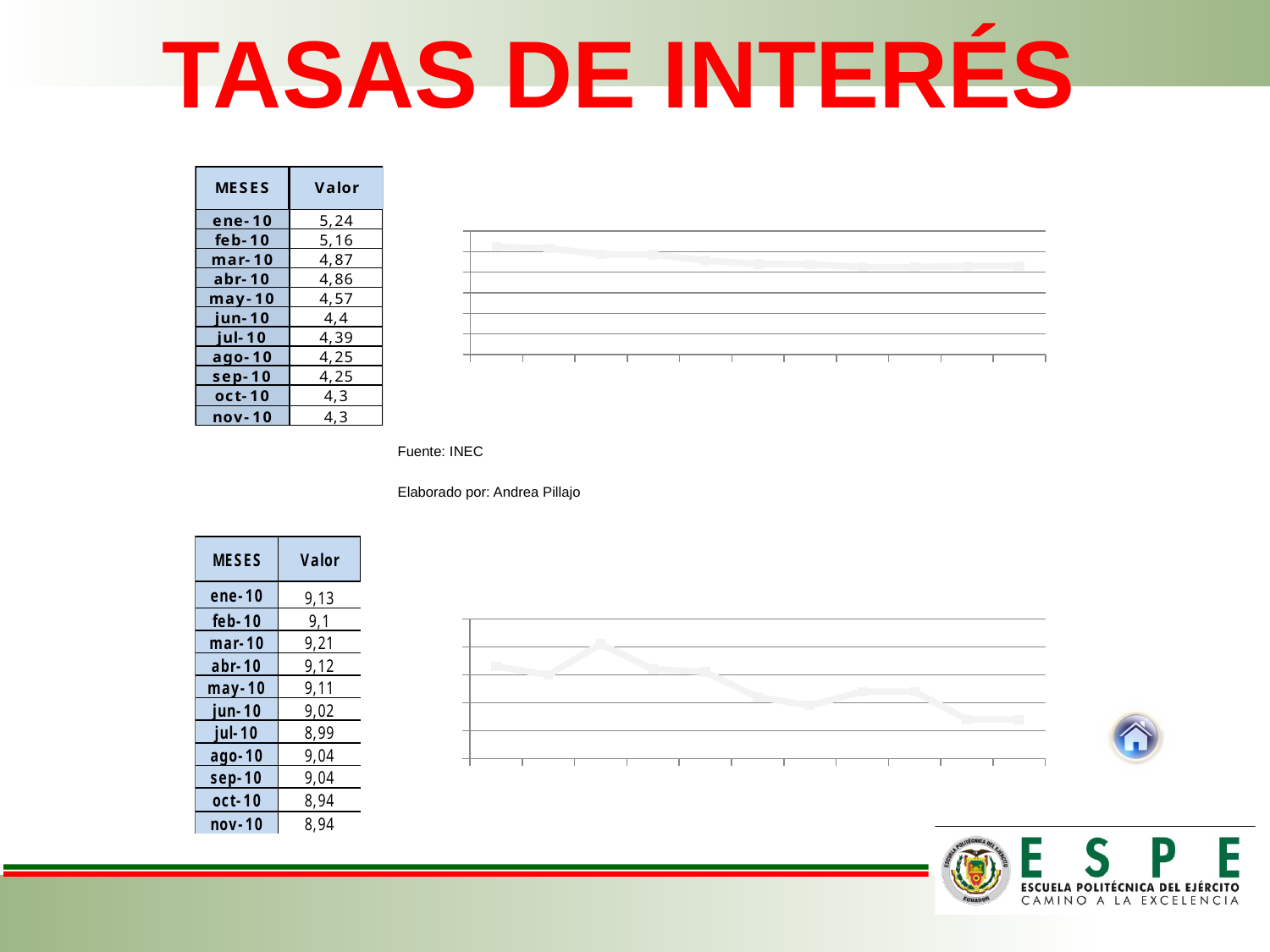
What kind of chart is the top chart on the slide? line chart In the top chart, which month has the highest value? ene-10 In the bottom chart, which month has the highest value? mar-10 In the top chart's table, what is the value for ene-10? 5,24 What kind of chart is the bottom chart on the slide? line chart In the bottom chart, what is the difference between the values for mar-10 and nov-10? 0,27 In the bottom chart's table, what is the value for jul-10? 8,99 In the top chart, do the values rise or fall from ene-10 to nov-10? fall In the top chart, what is the difference between the values for ene-10 and nov-10? 0,94 In the bottom chart, which is larger, the value for mar-10 or the value for jun-10? mar-10 In the top chart (with the table beside it), how many months are plotted? 11 In the top chart's table, what is the value for may-10? 4,57